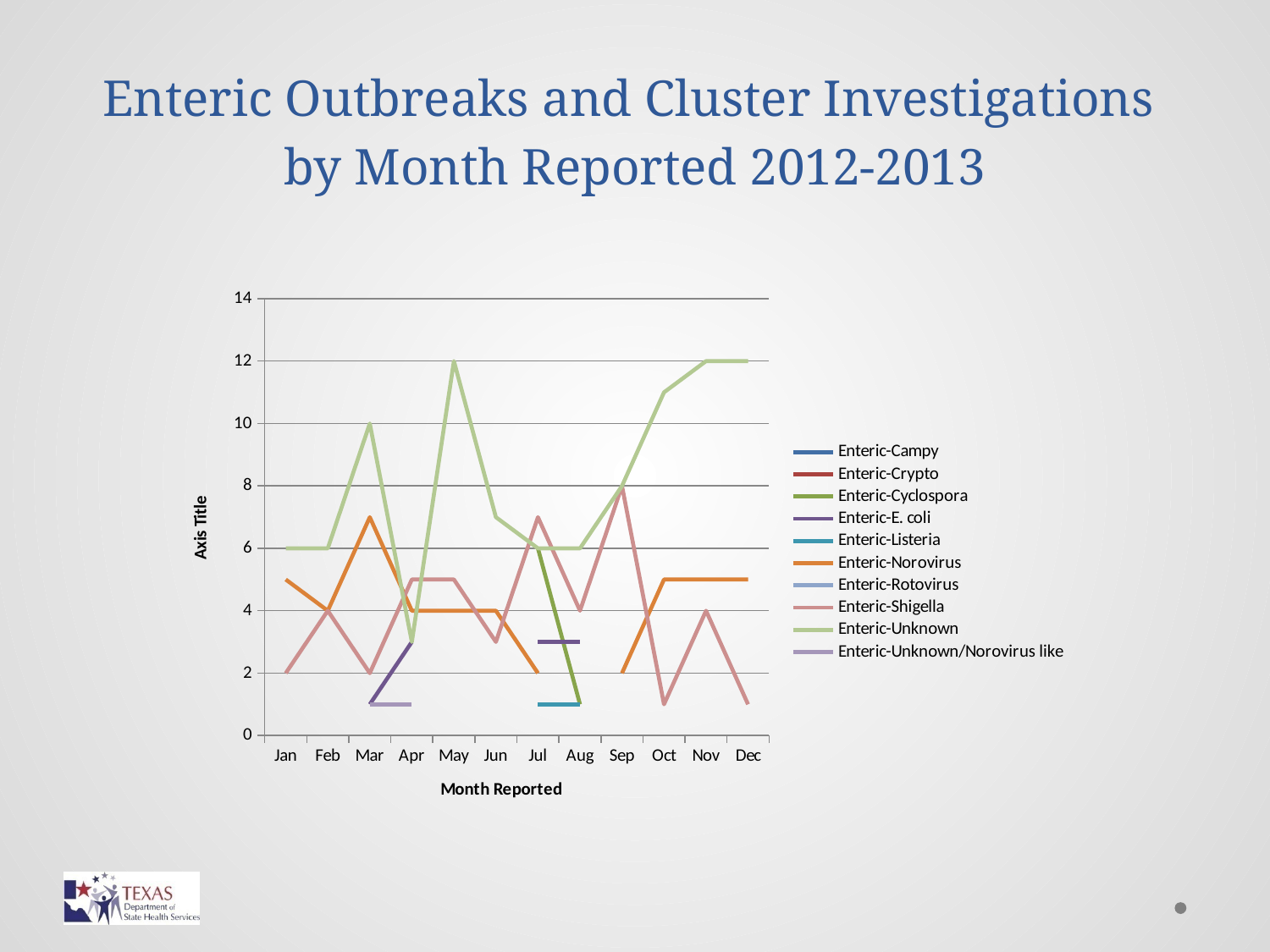
How many months are shown on the x axis? 12 Which series reaches the highest value on the chart? Enteric-Unknown In which month does Enteric-Shigella reach its highest value? Sep What is the value for Enteric-Unknown in May? 12 In Mar, which is larger: Enteric-Unknown or Enteric-Norovirus? Enteric-Unknown What kind of chart is shown on the slide? Line chart What is the value for Enteric-Unknown in Mar? 10 What is the value for Enteric-Norovirus in Feb? 4 What is the difference between Enteric-Unknown in May and Enteric-Unknown in Jan? 6 How many series does the legend list? 10 Is the value for Enteric-Shigella in Jul greater or less than 6? greater Is the value for Enteric-Unknown in Oct greater or less than 10? greater